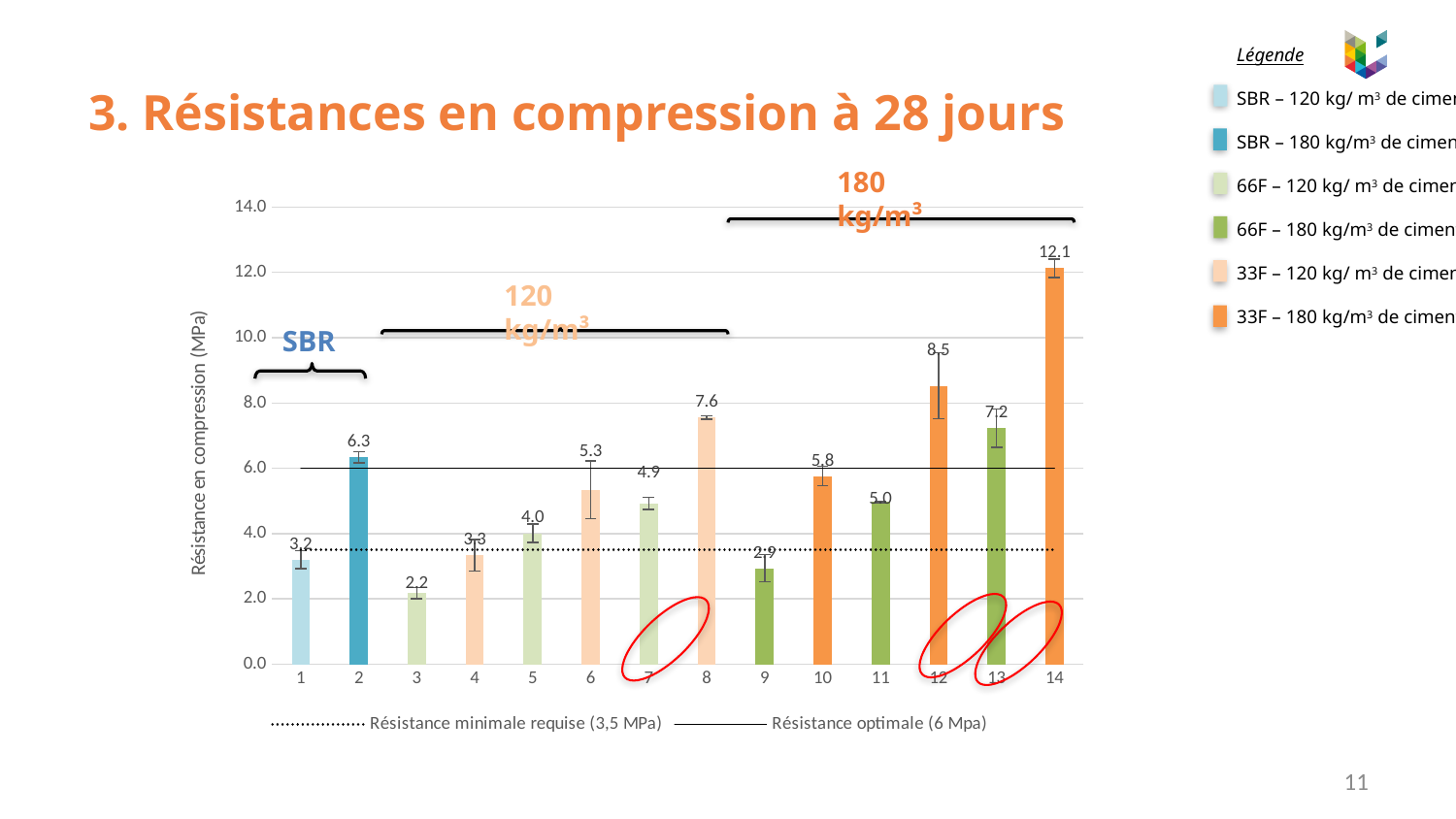
What is the difference between the values of bar 12 and bar 13? 1.3 How many bars are plotted on the chart? 14 Is the value for bar 9 greater or less than 4.0? less What type of chart is shown on the slide? bar chart What is the compressive strength value shown for bar 14? 12.1 Which bar has the lowest compressive strength? 3 Which bar has the highest compressive strength? 14 What is the value labelled on bar 2? 6.3 What is the label of the y axis? Résistance en compression (MPa) What is the value labelled on bar 8? 7.6 Which has a larger value, bar 10 or bar 11? bar 10 What value does the dotted reference line 'Résistance minimale requise' represent? 3,5 MPa